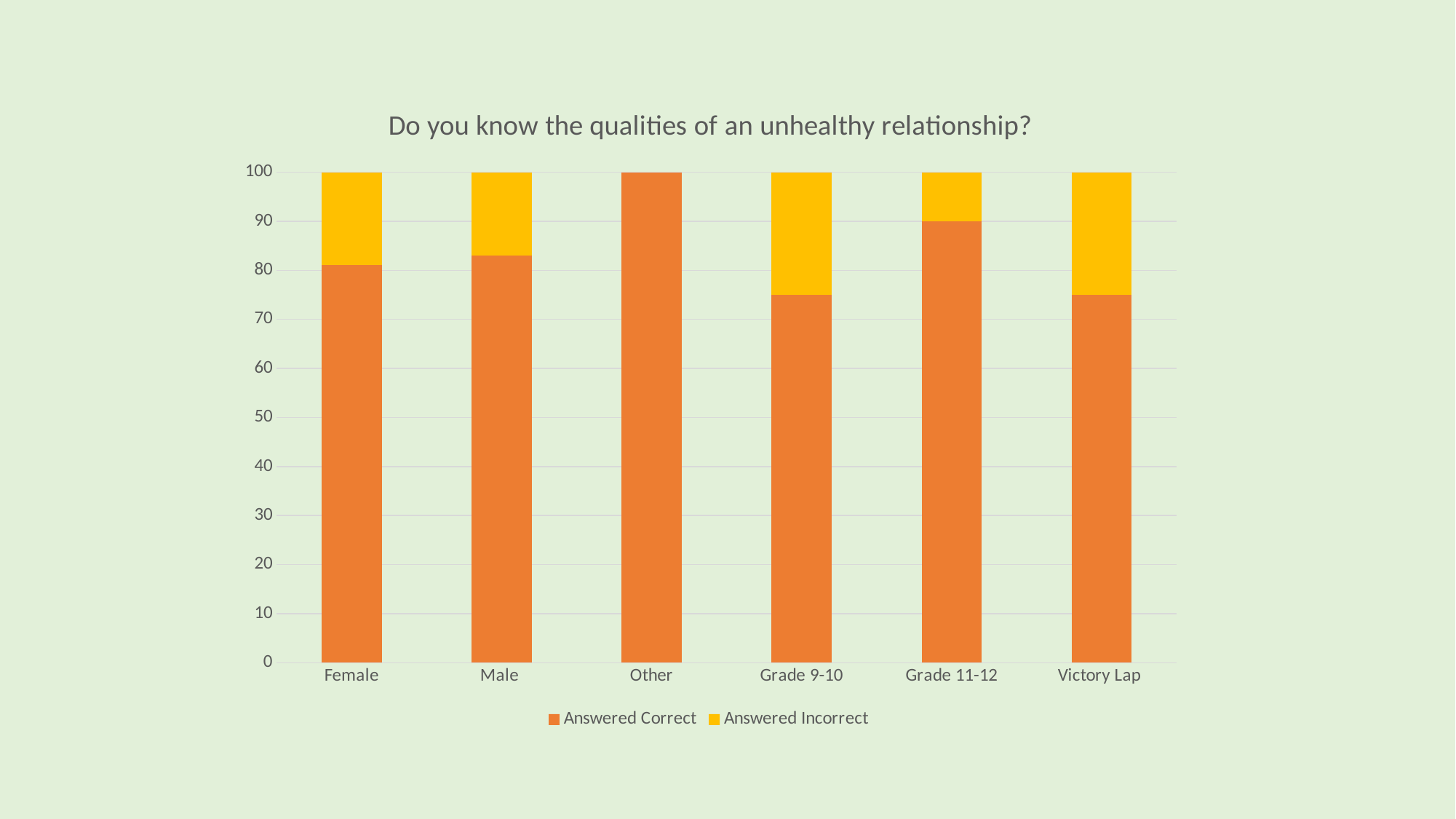
What is the Answered Correct value for Other? 100 Is the Answered Correct value for Grade 9-10 greater or less than 80? less What is the total of the stacked bar for Female? 100 How many series does the legend list? 2 Which category has the highest Answered Correct value? Other How many categories are shown along the x axis? 6 What is the title of the chart? Do you know the qualities of an unhealthy relationship? Is the Answered Correct value for Male greater or less than 80? greater Which category has the lowest Answered Incorrect value? Other Which is larger, the Answered Correct value for Female or for Grade 11-12? Grade 11-12 What is the Answered Correct value for Grade 11-12? 90 What kind of chart is shown on the slide? Stacked bar chart